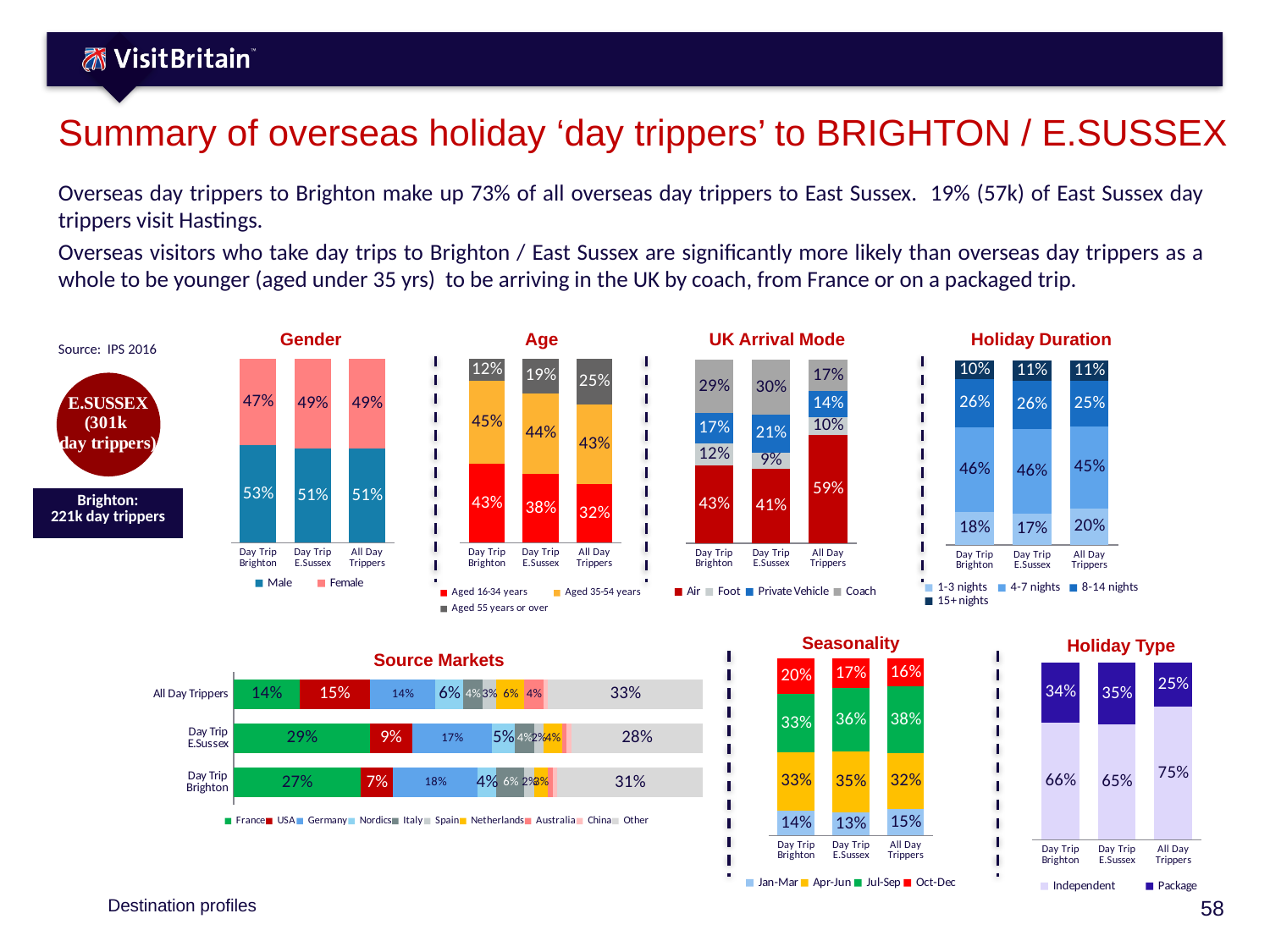
In the Seasonality chart, what percentage of All Day Trippers visit in Jul-Sep? 38% In the Source Markets chart, what percentage of Day Trip Brighton visitors come from France? 27% In the Holiday Duration chart, which duration category has the largest share for Day Trip Brighton? 4-7 nights In the UK Arrival Mode chart, what percentage of Day Trip E.Sussex visitors arrive by coach? 30% In the Holiday Type chart, what percentage of Day Trip E.Sussex visitors are on a package holiday? 35% In the Seasonality chart, which quarter has the smallest share for Day Trip Brighton? Jan-Mar In the Holiday Duration chart, what percentage of Day Trip E.Sussex visitors stay 1-3 nights? 17% How many series does the legend of the UK Arrival Mode chart list? 4 In the UK Arrival Mode chart, what is the difference between the Air share for All Day Trippers and for Day Trip Brighton? 16% In the Gender chart, what percentage of Day Trip Brighton visitors are male? 53% In the Source Markets chart, which is larger for Day Trip E.Sussex: the France share or the Germany share? France In the Age chart, what share of All Day Trippers are aged 55 years or over? 25%